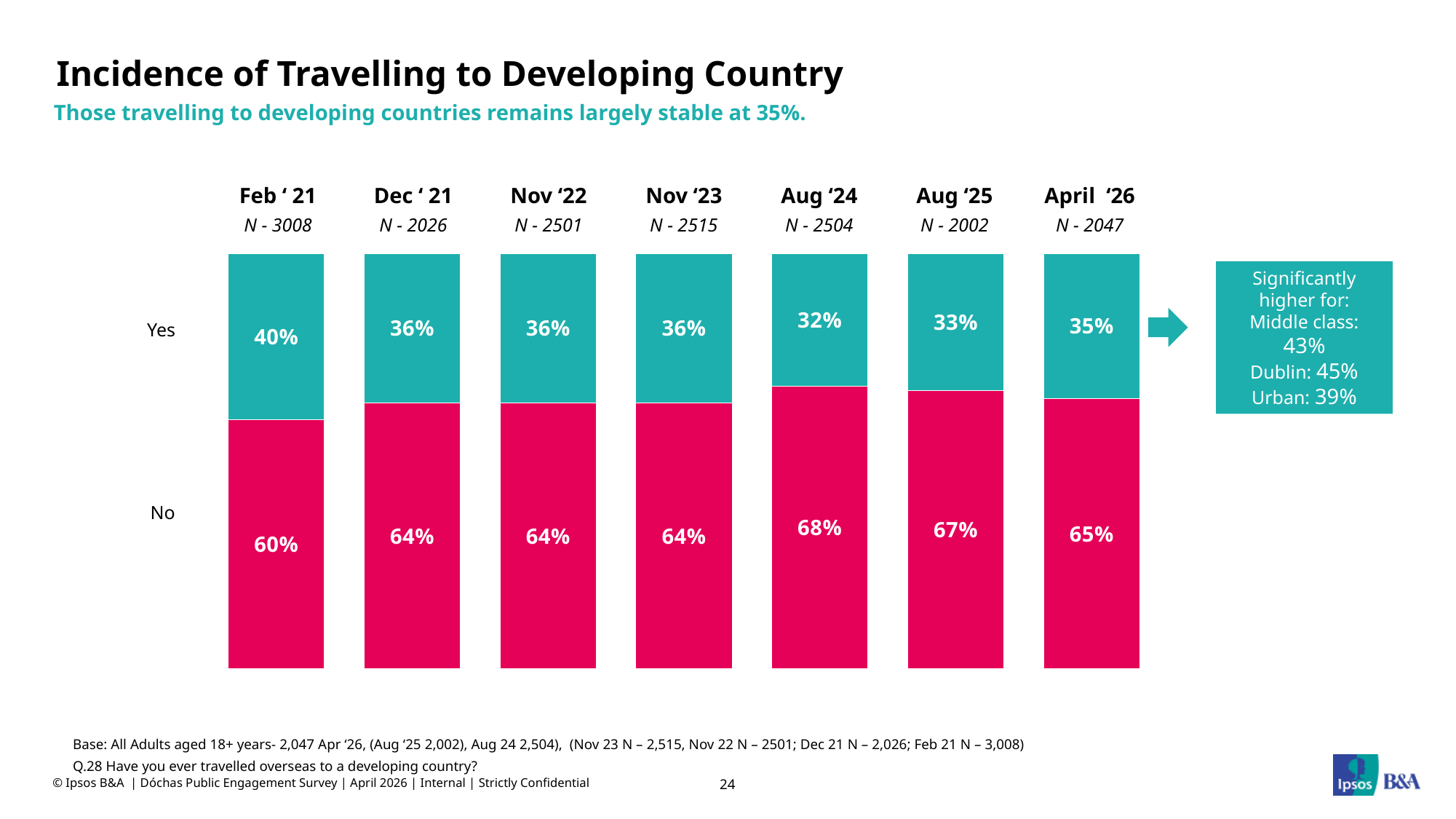
What percentage answered No in Aug '24? 68% In which wave is the Yes share lowest? Aug '24 What is the difference between the Yes share in Feb '21 and the Yes share in Aug '24? 8 percentage points How many survey waves are shown on the chart? 7 What type of chart is shown on the slide? Stacked bar chart What is the No value for Aug '25? 67% What is the sample size (N) for the Nov '22 wave? 2501 In which wave is the Yes share highest? Feb '21 What is the total of the Yes and No segments for the Nov '23 bar? 100% Which is larger: the Yes share in Aug '25 or the Yes share in April '26? April '26 What percentage answered Yes in Feb '21? 40% What is the Yes value for April '26? 35%